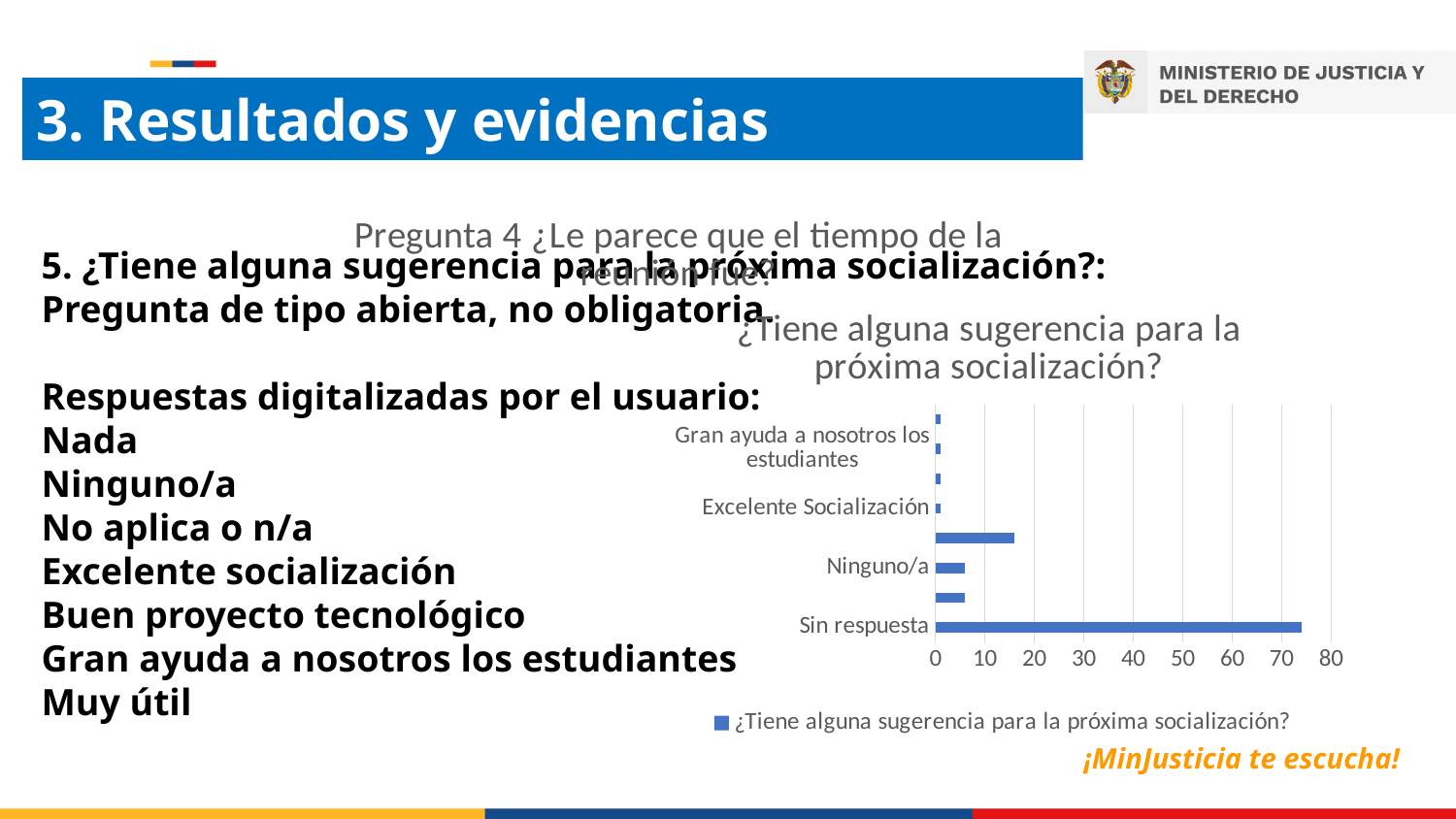
How many series does the chart legend list? 1 Is the value for Gran ayuda a nosotros los estudiantes greater or less than 10? less Is the value for Ninguno/a greater or less than 10? less What is the maximum value shown on the horizontal axis of the chart? 80 What is the title of the chart? ¿Tiene alguna sugerencia para la próxima socialización? Which is larger, the value for Sin respuesta or the value for Ninguno/a? Sin respuesta Which category has the highest value in the chart? Sin respuesta Which is larger, the value for Ninguno/a or the value for Excelente Socialización? Ninguno/a What kind of chart is shown on the slide? bar chart Is the value for Sin respuesta greater or less than 60? greater